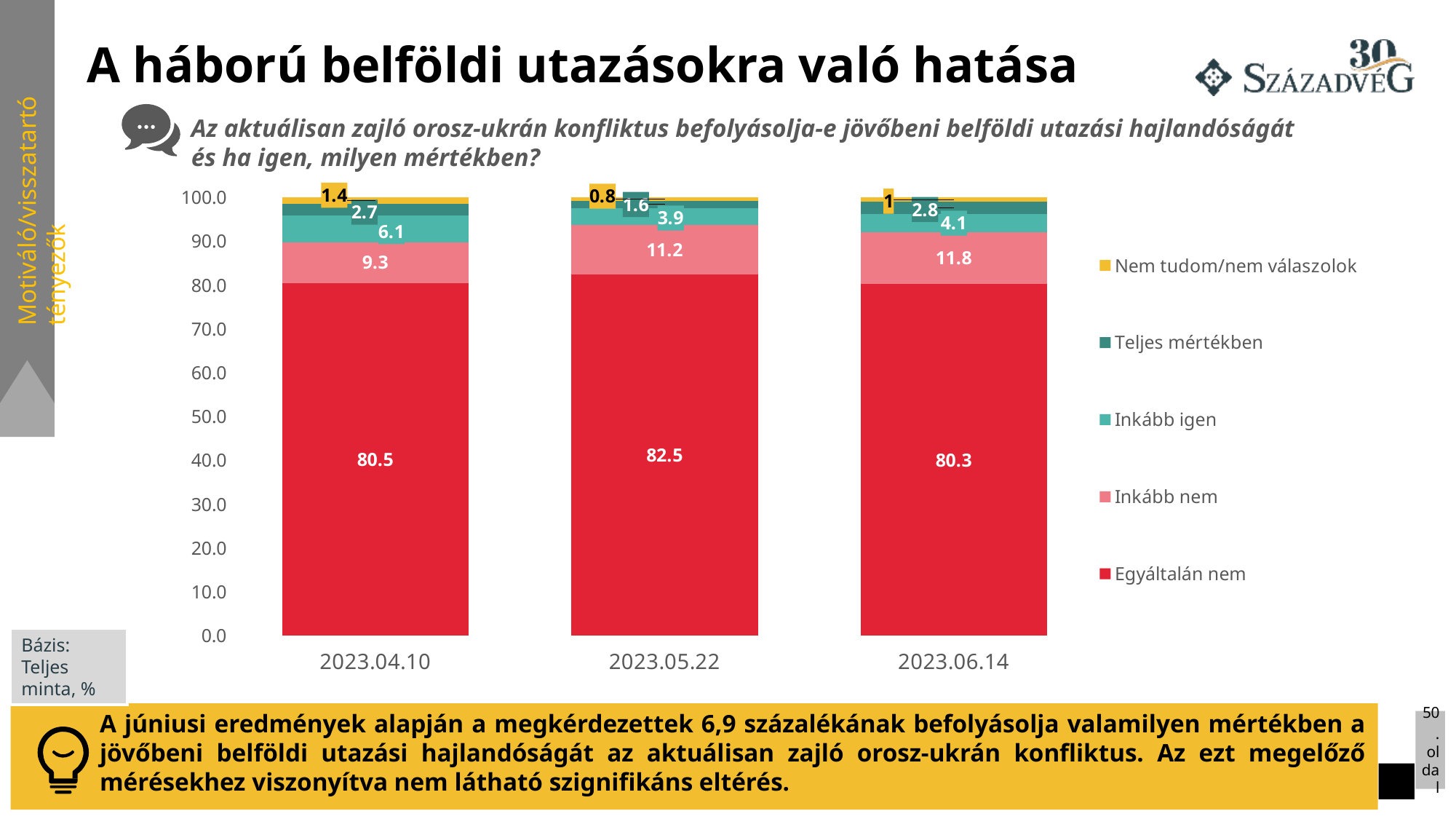
How many series does the chart legend list? 5 How many dates (categories) are shown on the x axis of the chart? 3 Which is larger: the 'Teljes mértékben' value on 2023.06.14 or on 2023.04.10? 2023.06.14 On which date is the 'Inkább igen' value the lowest? 2023.05.22 What is the difference between the 'Inkább nem' values on 2023.06.14 and 2023.04.10? 2.5 What is the value for 'Inkább igen' on 2023.04.10? 6.1 What is the value for 'Inkább nem' on 2023.06.14? 11.8 On which date is the 'Egyáltalán nem' value the highest? 2023.05.22 What is the value for 'Teljes mértékben' on 2023.05.22? 1.6 What type of chart is shown on the slide? stacked bar chart What is the value for 'Egyáltalán nem' on 2023.05.22? 82.5 Which legend entry is shown in yellow? Nem tudom/nem válaszolok